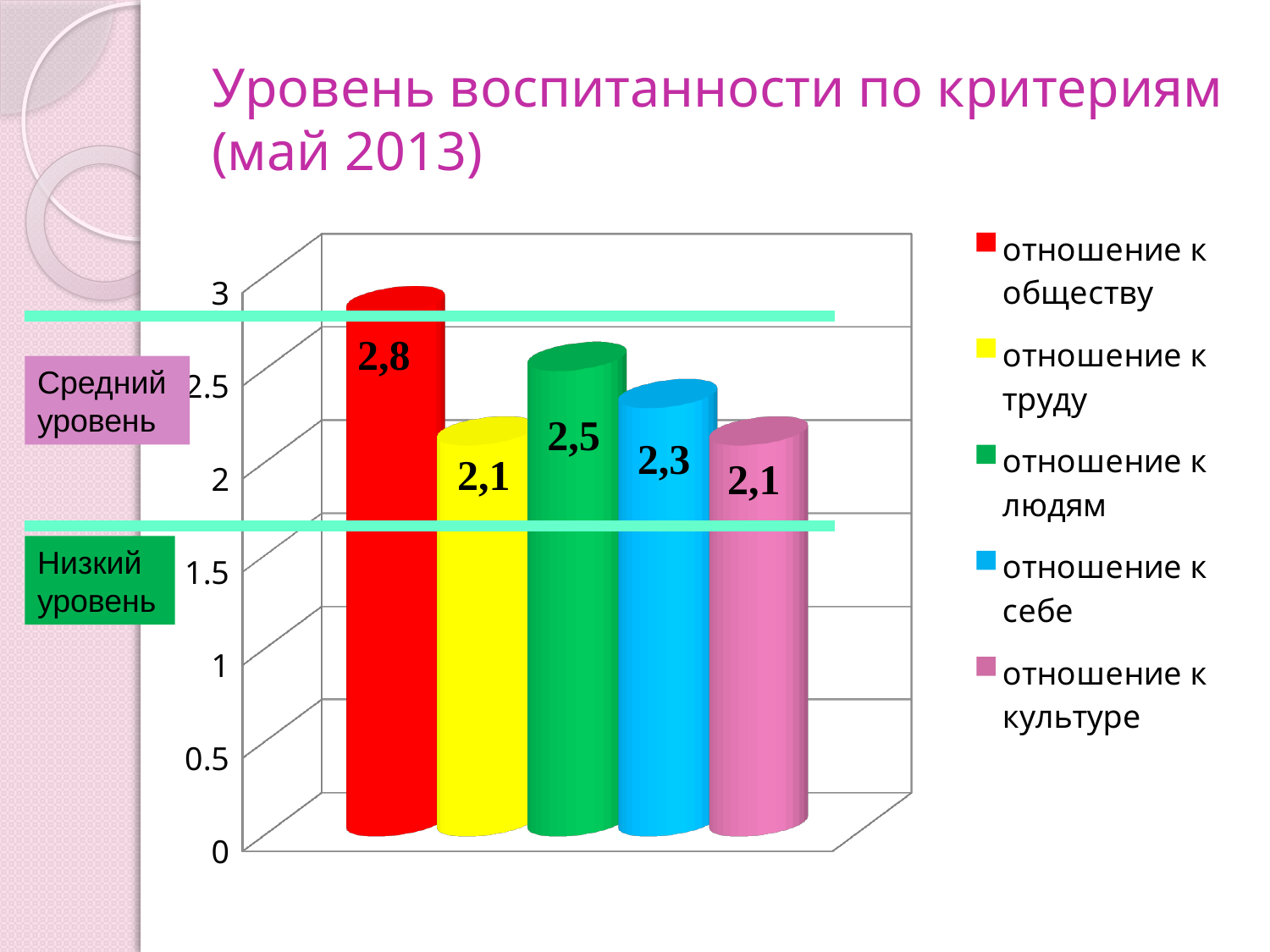
Is the value for «отношение к обществу» greater or less than 2.5? greater How many bars are plotted in the chart? 5 What is the difference between the values for «отношение к обществу» and «отношение к труду»? 0,7 What is the value for «отношение к себе»? 2,3 What is the value for «отношение к обществу»? 2,8 What type of chart is shown on the slide? bar chart Which is larger, the value for «отношение к людям» or the value for «отношение к себе»? отношение к людям Which criterion has the highest value? отношение к обществу What is the value for «отношение к людям»? 2,5 What is the value for «отношение к культуре»? 2,1 What is the difference between the values for «отношение к людям» and «отношение к себе»? 0,2 How many entries does the legend list? 5